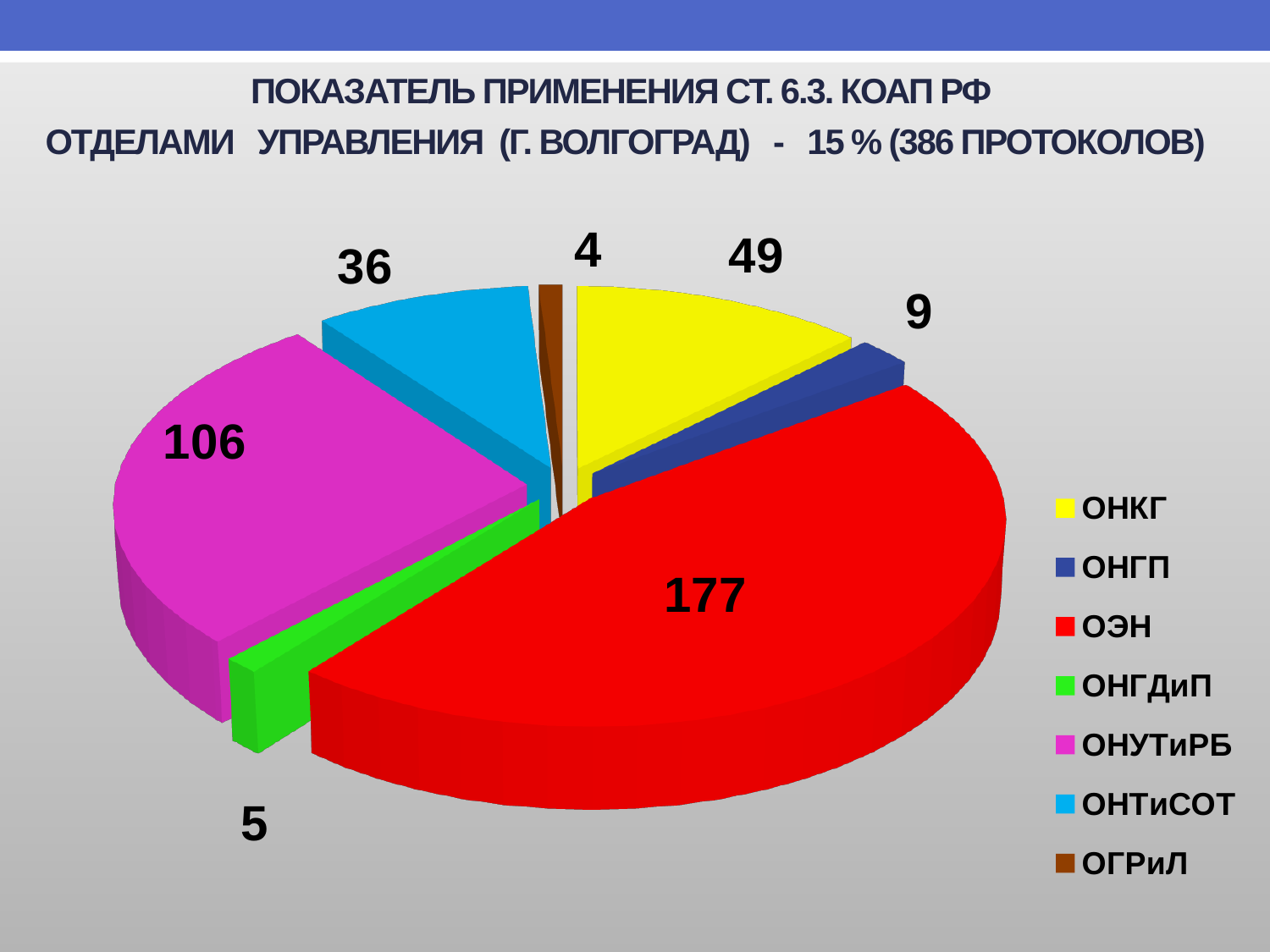
Which is larger, the value for ОНГП or the value for ОНГДиП? ОНГП What is the value for ОЭН? 177 Which category has the smallest slice? ОГРиЛ What colour is the slice for ОНТиСОТ? light blue What is the value for ОГРиЛ? 4 What is the value for ОНКГ? 49 What is the difference between the values for ОЭН and ОНУТиРБ? 71 What is the value for ОНУТиРБ? 106 How many slices does the pie chart have? 7 What is the value for ОНТиСОТ? 36 Which category has the largest slice? ОЭН What kind of chart is shown on the slide? pie chart